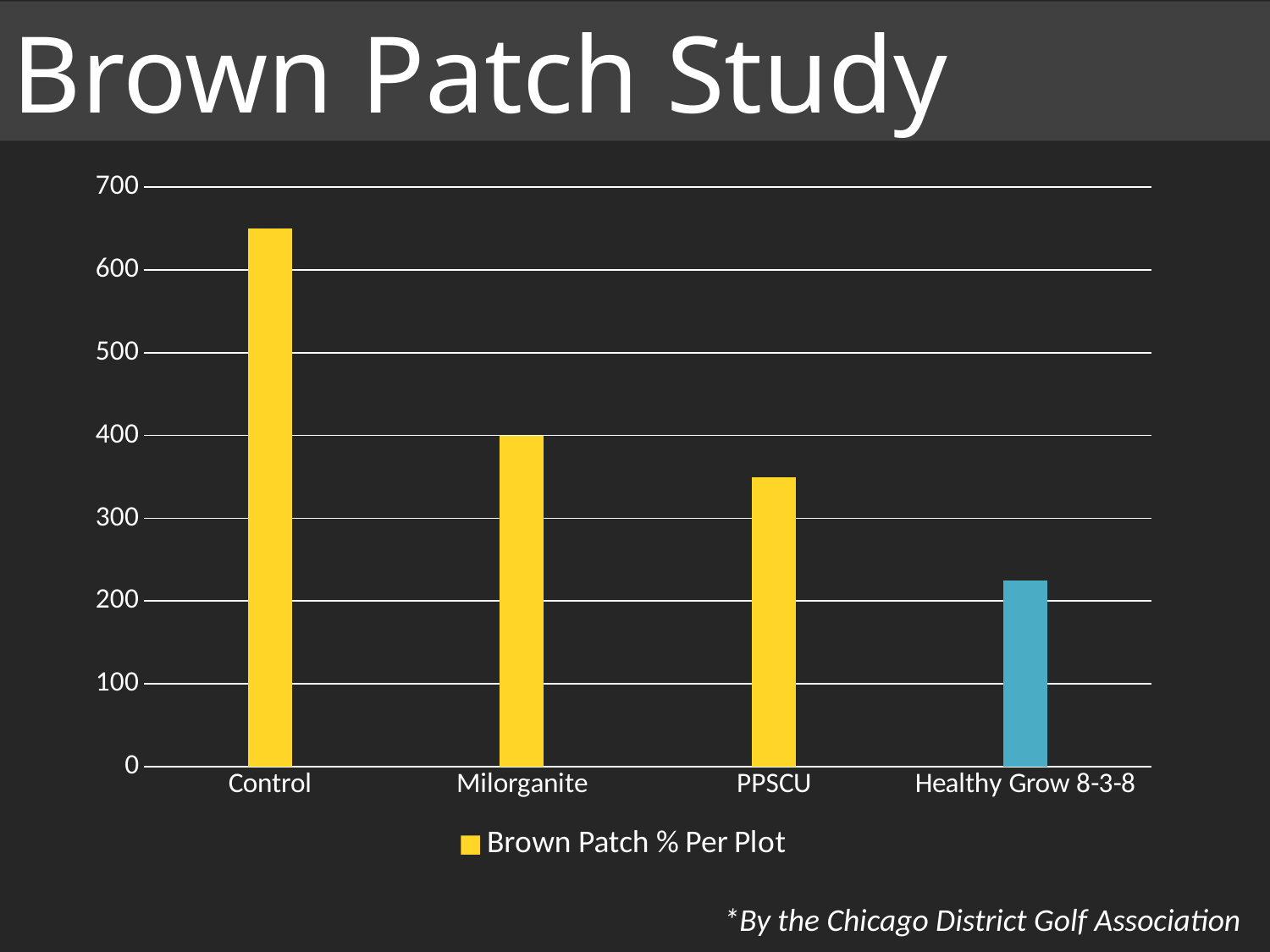
What kind of chart is shown on the slide? bar chart Which is larger, the value for Milorganite or the value for PPSCU? Milorganite Is the value for Healthy Grow 8-3-8 greater or less than 300? less Which category has the lowest Brown Patch % Per Plot? Healthy Grow 8-3-8 What is the series name shown in the legend? Brown Patch % Per Plot Is the value for Control greater or less than 600? greater Is the value for PPSCU greater or less than 400? less How many categories are shown on the x axis? 4 Do the values rise or fall from left to right across the categories? fall Which category has the highest Brown Patch % Per Plot? Control How many series does the legend list? 1 What is the Brown Patch % Per Plot value for Milorganite? 400